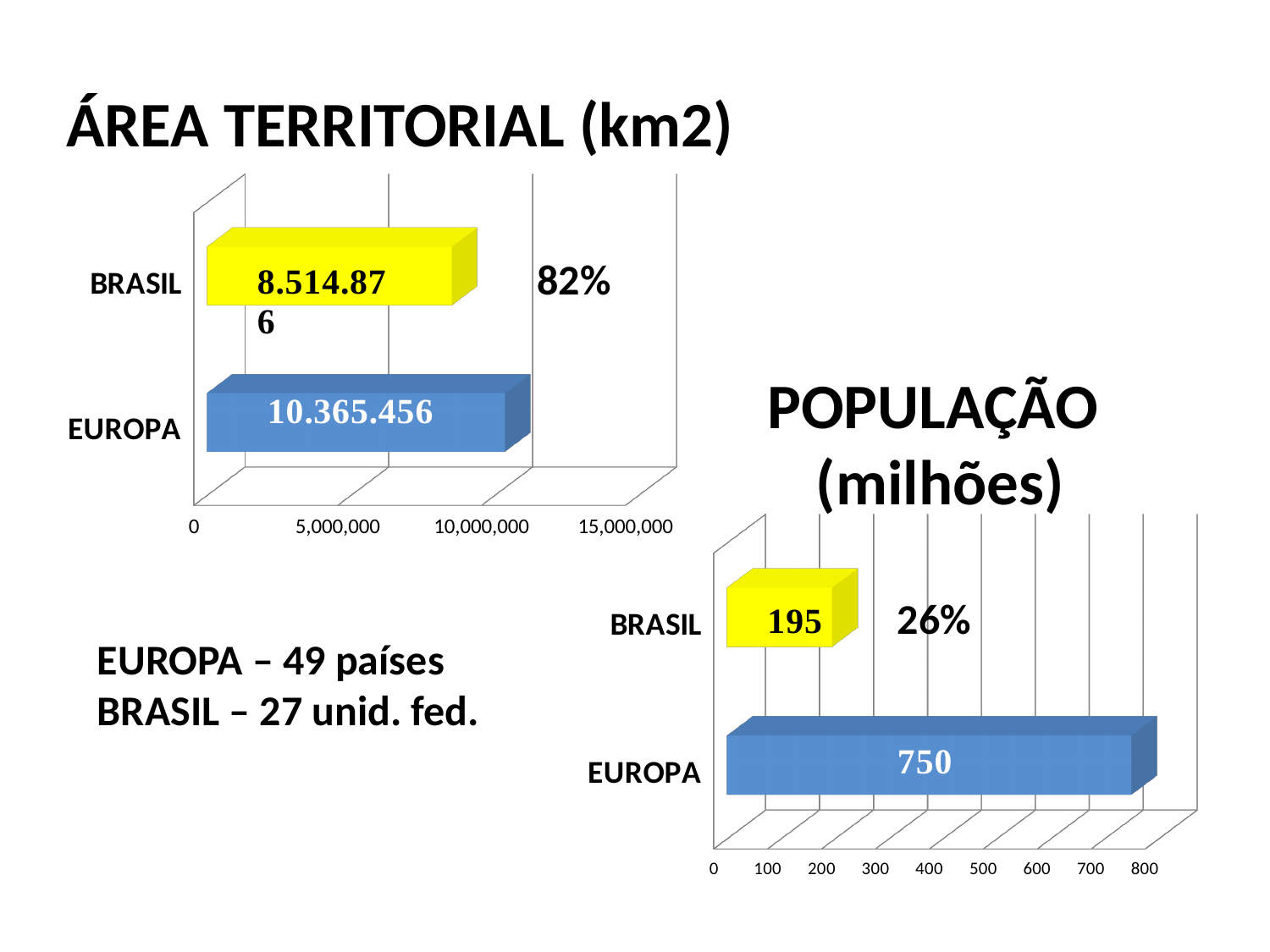
In the POPULAÇÃO (milhões) chart, how many categories are shown? 2 In the ÁREA TERRITORIAL (km2) chart, which category has the larger area? EUROPA In the ÁREA TERRITORIAL (km2) chart, is the value for BRASIL greater or less than 10,000,000? less In the POPULAÇÃO (milhões) chart, what is the value for BRASIL? 195 In the POPULAÇÃO (milhões) chart, what percentage label is shown next to the BRASIL bar? 26% In the ÁREA TERRITORIAL (km2) chart, what is the value for EUROPA? 10.365.456 In the ÁREA TERRITORIAL (km2) chart, what is the value for BRASIL? 8.514.876 In the POPULAÇÃO (milhões) chart, what is the value for EUROPA? 750 What type of chart is the POPULAÇÃO (milhões) chart? Bar chart In the POPULAÇÃO (milhões) chart, which category has the smaller value? BRASIL In the ÁREA TERRITORIAL (km2) chart, what is the difference between the EUROPA and BRASIL values? 1.850.580 In the POPULAÇÃO (milhões) chart, what is the difference between the EUROPA and BRASIL values? 555